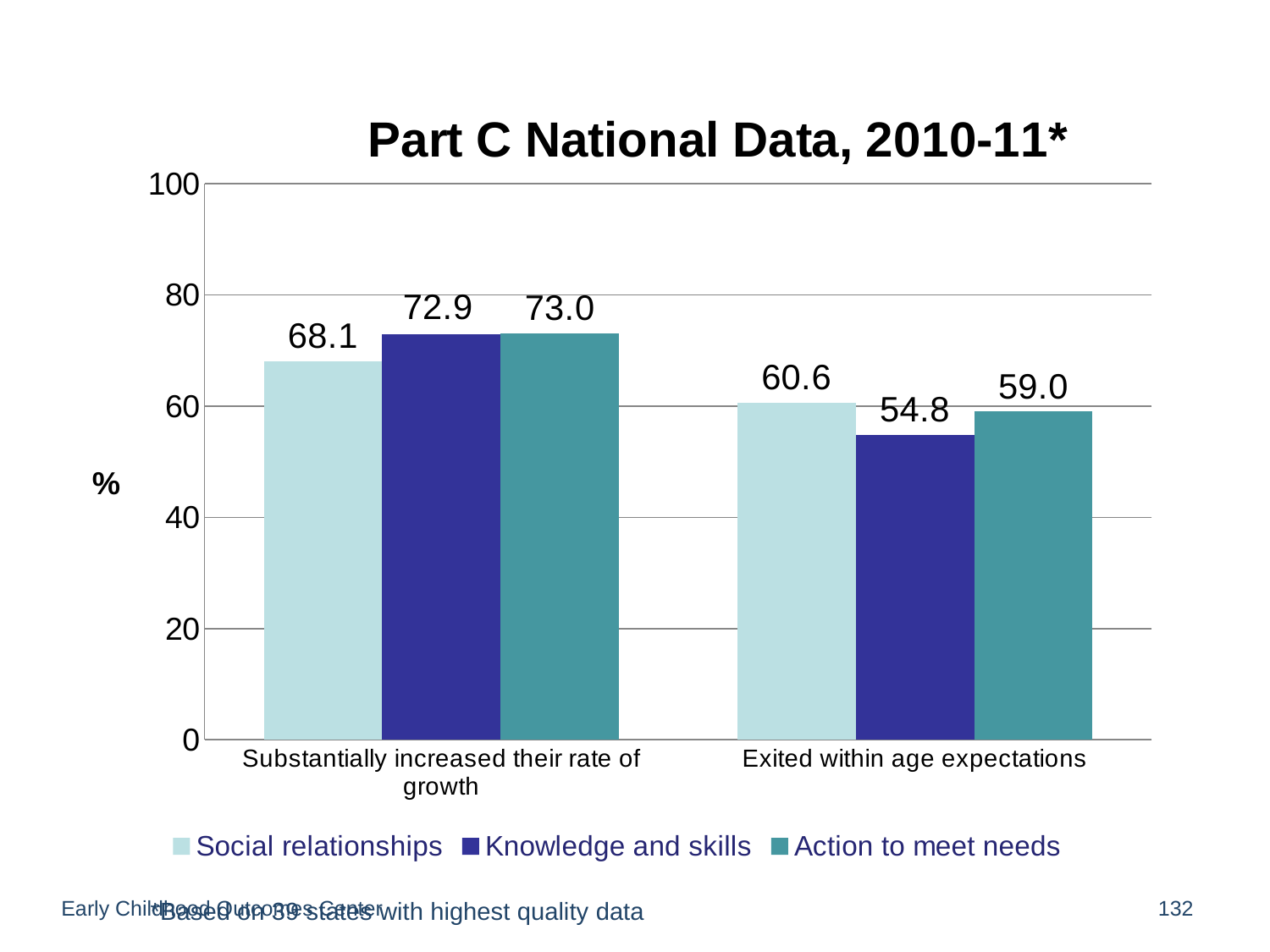
What is the difference between the Social relationships values for 'Substantially increased their rate of growth' and 'Exited within age expectations'? 7.5 Which series has the highest value in the 'Exited within age expectations' category? Social relationships Which is larger: Knowledge and skills or Action to meet needs in the 'Exited within age expectations' category? Action to meet needs What is the value for Social relationships in the 'Substantially increased their rate of growth' category? 68.1 What is the value for Action to meet needs in the 'Substantially increased their rate of growth' category? 73.0 What kind of chart is shown on the slide? bar chart What is the value for Knowledge and skills in the 'Exited within age expectations' category? 54.8 How many categories are shown on the x axis? 2 Which series has the lowest value in the 'Substantially increased their rate of growth' category? Social relationships Is the value for Knowledge and skills in 'Exited within age expectations' greater or less than 60? less What is the title of the chart? Part C National Data, 2010-11* How many series does the legend list? 3